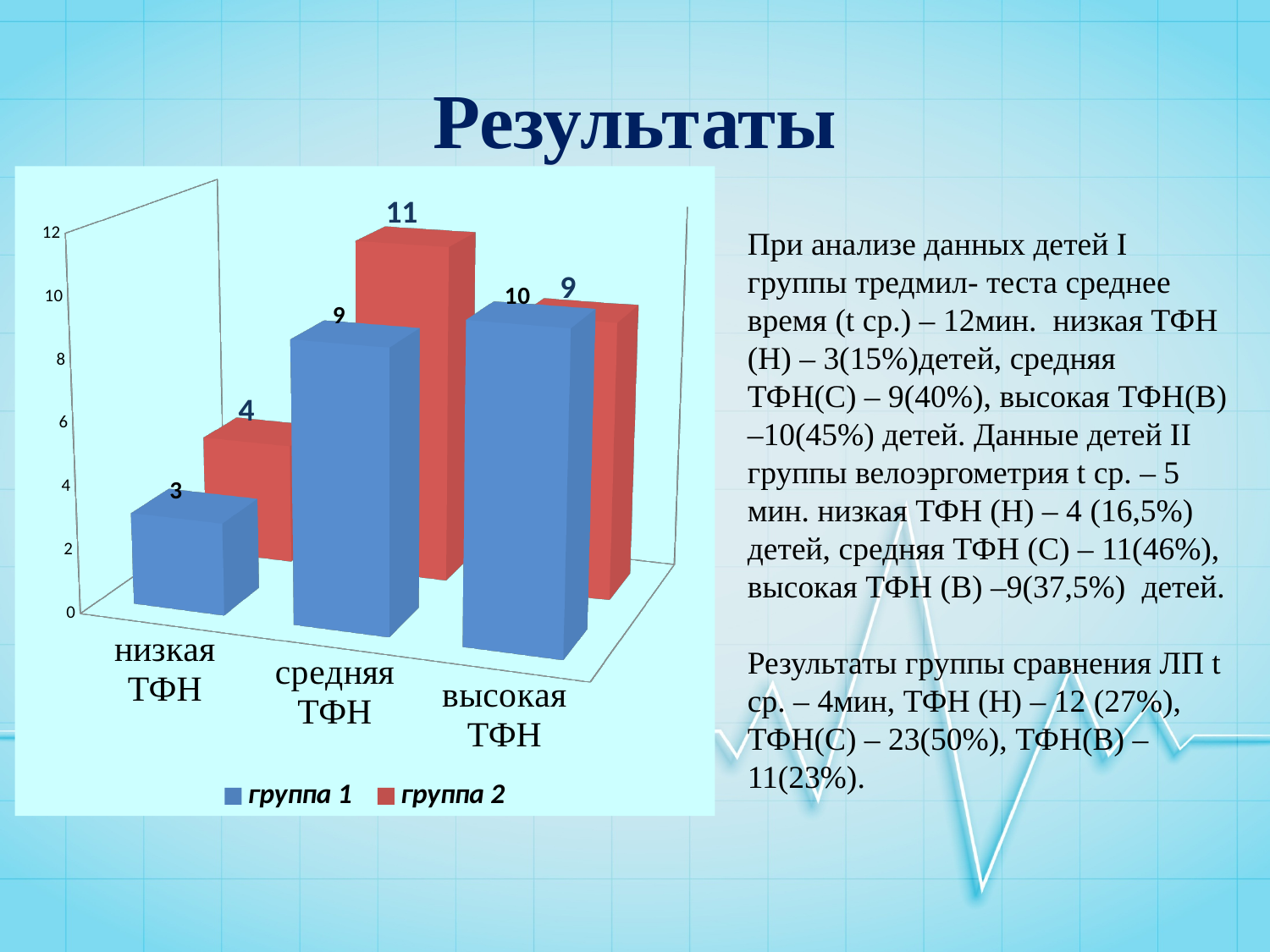
What is the difference between группа 2 and группа 1 in the средняя ТФН category? 2 Which is larger in the высокая ТФН category, группа 1 or группа 2? группа 1 What is the value for группа 1 in the низкая ТФН category? 3 How many series does the legend list? 2 What is the value for группа 2 in the высокая ТФН category? 9 What is the value for группа 1 in the высокая ТФН category? 10 Which category has the highest value for группа 2? средняя ТФН What kind of chart is shown on the slide? bar chart Which category has the lowest value for группа 1? низкая ТФН Which colour represents группа 2 in the chart? red How many categories are shown on the x axis? 3 What is the value for группа 2 in the средняя ТФН category? 11